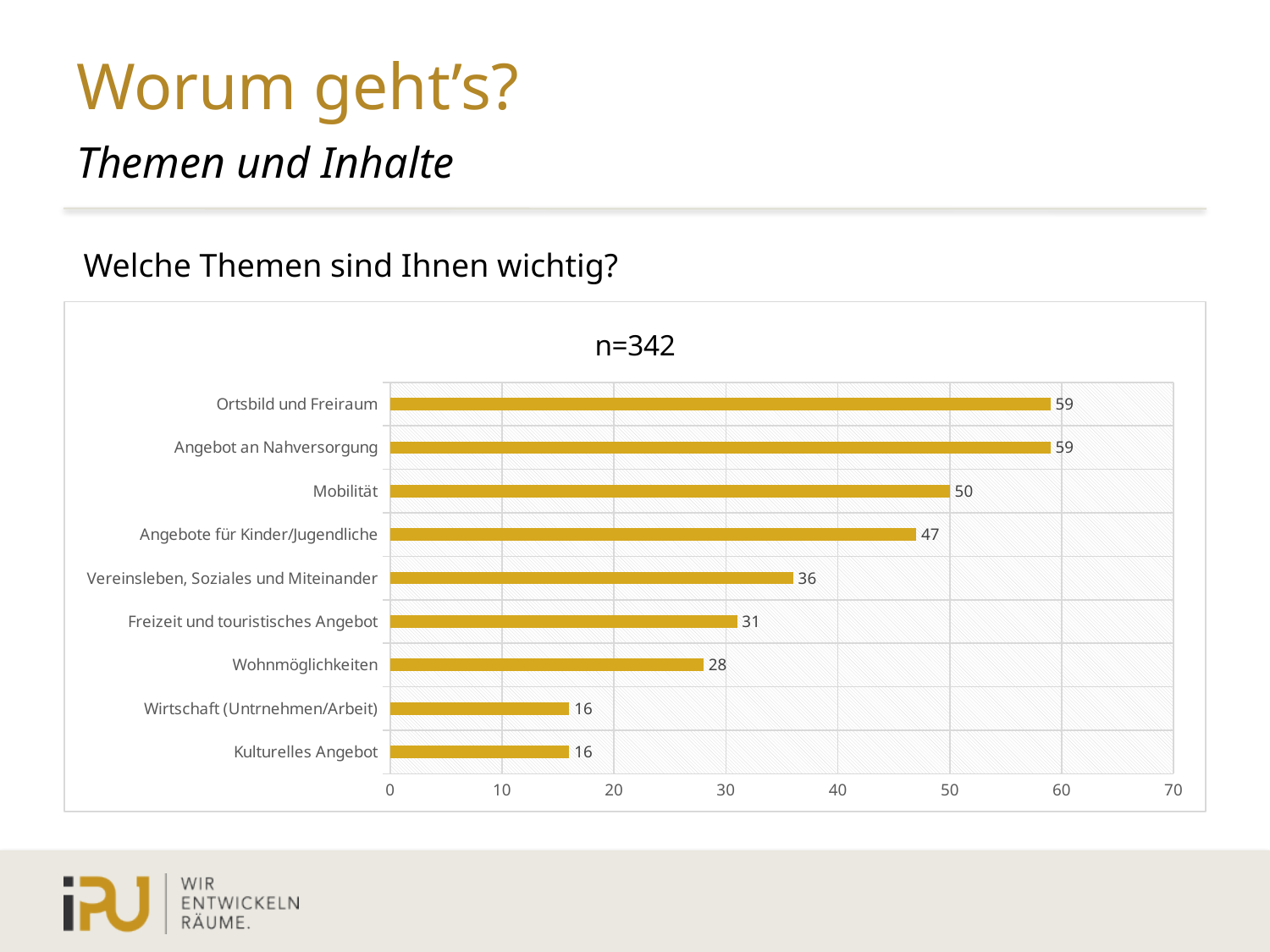
What kind of chart is shown on the slide? bar chart How many categories are shown in the chart? 9 What is the value for Mobilität? 50 What is the value for Wohnmöglichkeiten? 28 What is the value for Vereinsleben, Soziales und Miteinander? 36 Which category has the lowest value, Freizeit und touristisches Angebot or Kulturelles Angebot? Kulturelles Angebot What is the difference between the values for Mobilität and Wohnmöglichkeiten? 22 What is the difference between the values for Ortsbild und Freiraum and Kulturelles Angebot? 43 Is the value for Freizeit und touristisches Angebot greater or less than 40? less Which is larger, the value for Angebote für Kinder/Jugendliche or the value for Vereinsleben, Soziales und Miteinander? Angebote für Kinder/Jugendliche What is the title of the chart? n=342 What is the value for Angebote für Kinder/Jugendliche? 47